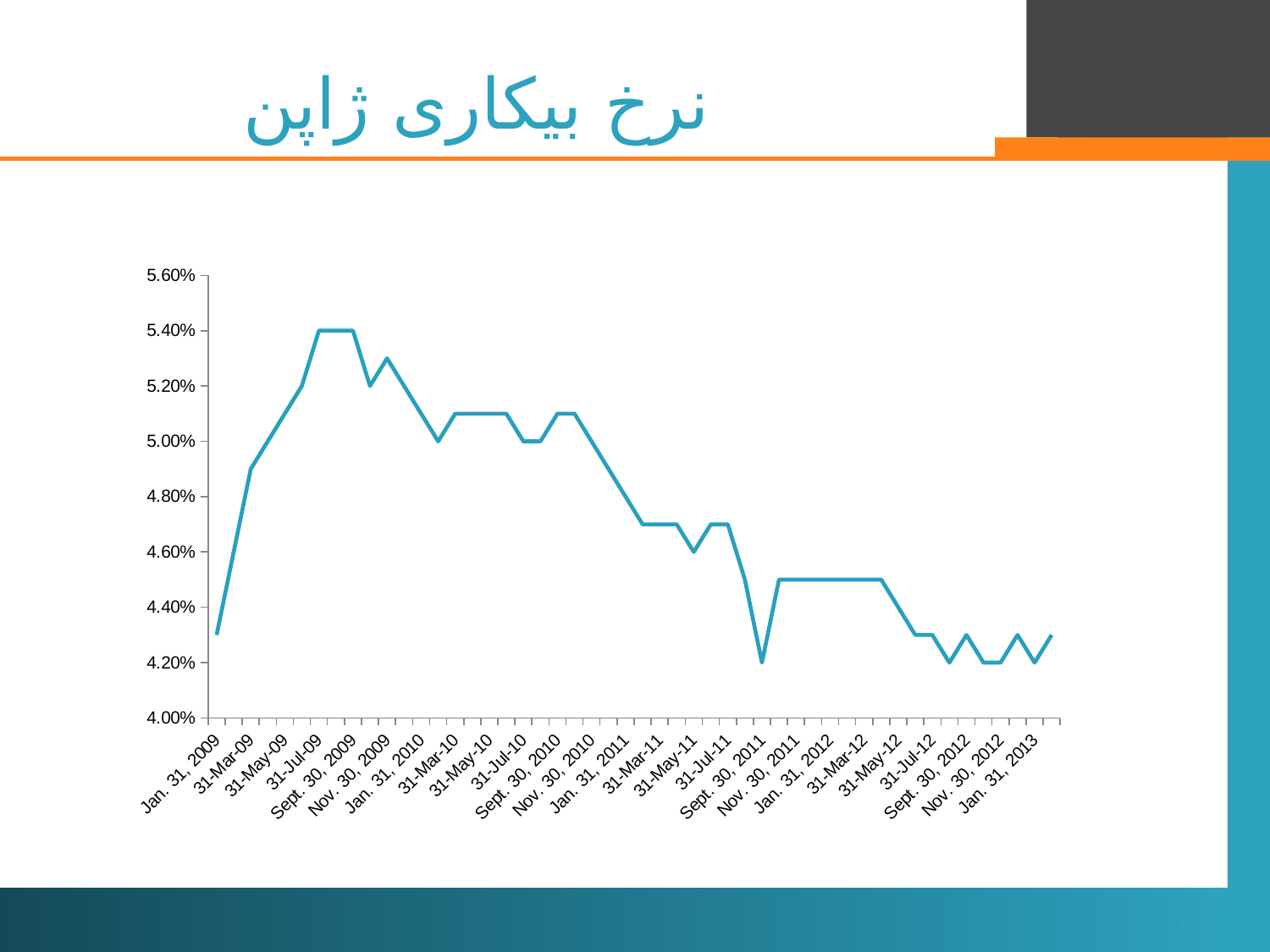
What is the highest value the line reaches? 5.40% What kind of chart is shown on the slide? line chart Is the value for Jan. 31, 2012 greater or less than 4.60%? less Is the value for Nov. 30, 2009 greater or less than 5.00%? greater Which is larger, the value for 31-Jul-09 or the value for Jan. 31, 2013? 31-Jul-09 What is the value for 31-Jul-09? 5.40% Is the value for 31-Mar-11 greater or less than 4.80%? less What is the lowest value the line reaches? 4.20% How many date labels are shown on the x axis? 25 What is the difference between the highest value (5.40%) and the lowest value (4.20%) on the chart? 1.20% Does the line rise or fall from Sept. 30, 2009 to Jan. 31, 2013? fall